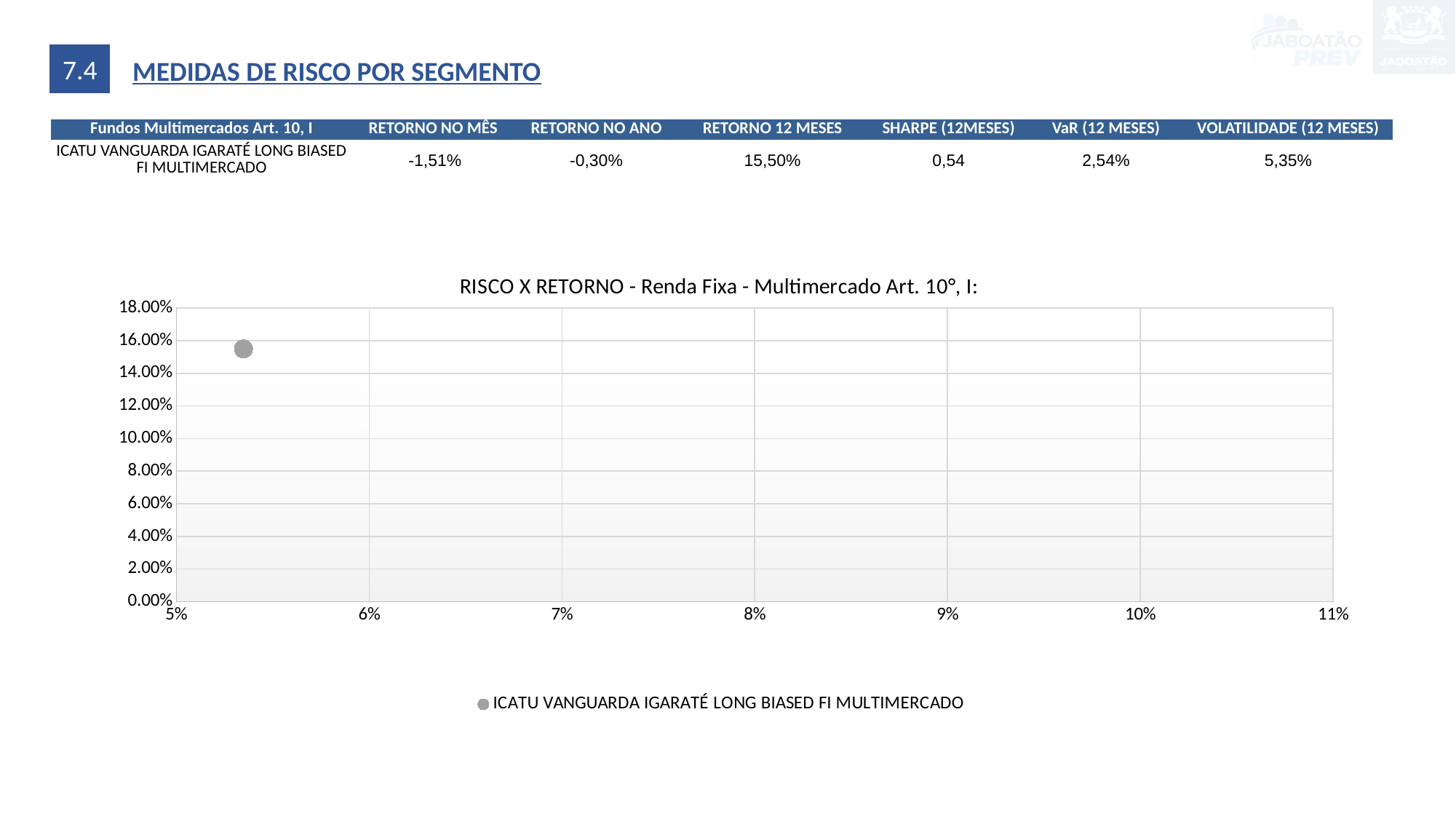
In the RISCO X RETORNO chart, is the vertical (return) value of the ICATU VANGUARDA IGARATÉ LONG BIASED FI MULTIMERCADO point greater or less than 14.00%? greater What is the title of the chart on the slide? RISCO X RETORNO - Renda Fixa - Multimercado Art. 10°, I: How many data points are plotted in the RISCO X RETORNO chart? 1 In the RISCO X RETORNO chart, is the horizontal (risk) value of the plotted point greater or less than 8%? less In the RISCO X RETORNO chart, is the horizontal (risk) value of the ICATU VANGUARDA IGARATÉ LONG BIASED FI MULTIMERCADO point greater or less than 6%? less How many series does the legend of the RISCO X RETORNO chart list? 1 Which fund is listed in the legend of the RISCO X RETORNO chart? ICATU VANGUARDA IGARATÉ LONG BIASED FI MULTIMERCADO What kind of chart is shown on the slide? scatter chart